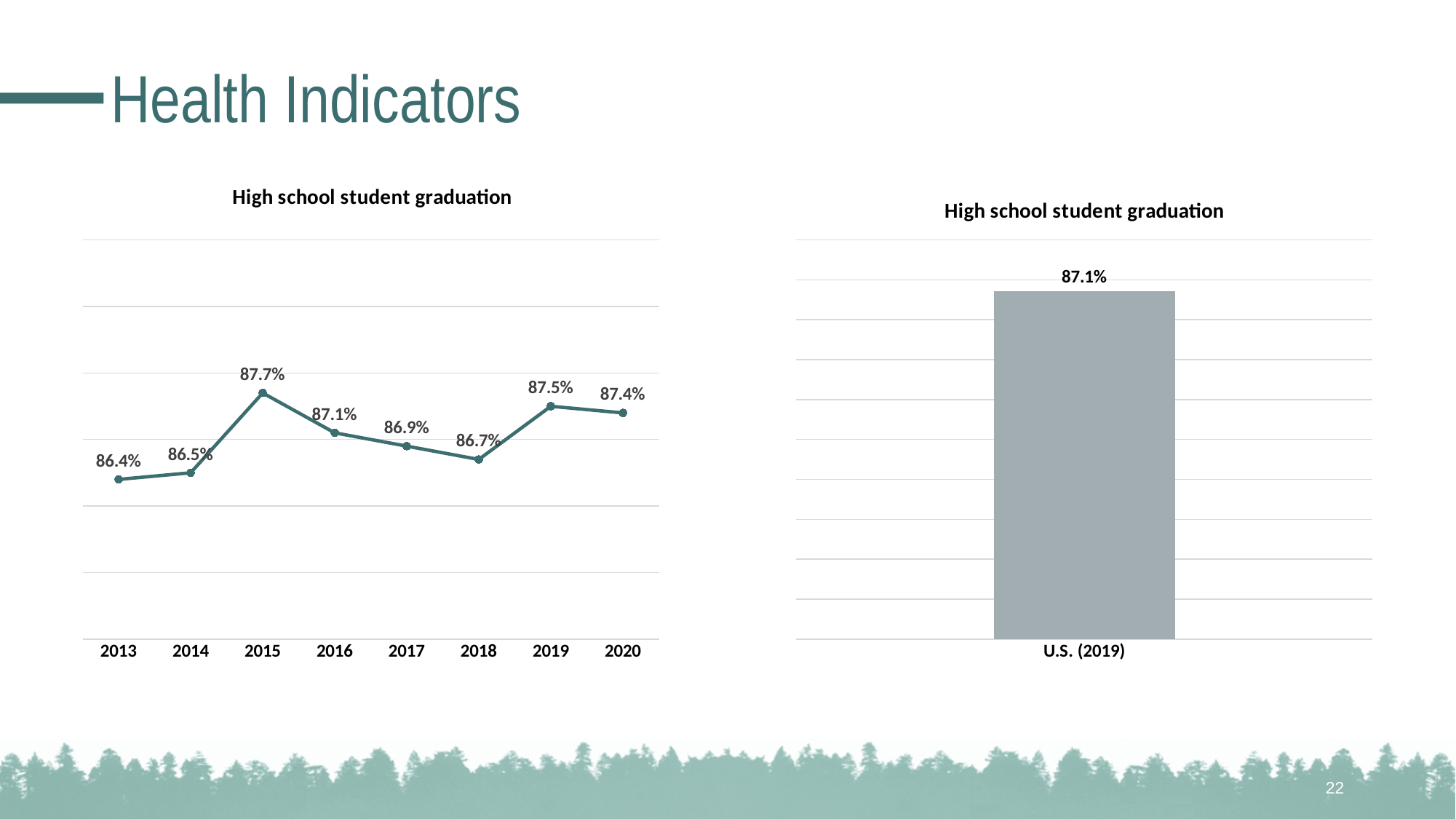
In the left-hand line chart, which year has the highest graduation rate? 2015 In the left-hand line chart, does the value rise or fall from 2015 to 2018? fall In the left-hand line chart, which year has the larger value, 2016 or 2018? 2016 In the left-hand line chart, which year has the lowest graduation rate? 2013 In the left-hand line chart, what is the difference between the 2015 value and the 2013 value? 1.3% What kind of chart is the left-hand chart? line chart In the right-hand bar chart, what is the value for U.S. (2019)? 87.1% What kind of chart is the right-hand chart? bar chart In the left-hand line chart, what is the value for 2020? 87.4% In the left-hand line chart, what is the high school student graduation value for 2015? 87.7% In the left-hand line chart, what is the value for 2013? 86.4% How many years are plotted in the left-hand line chart? 8